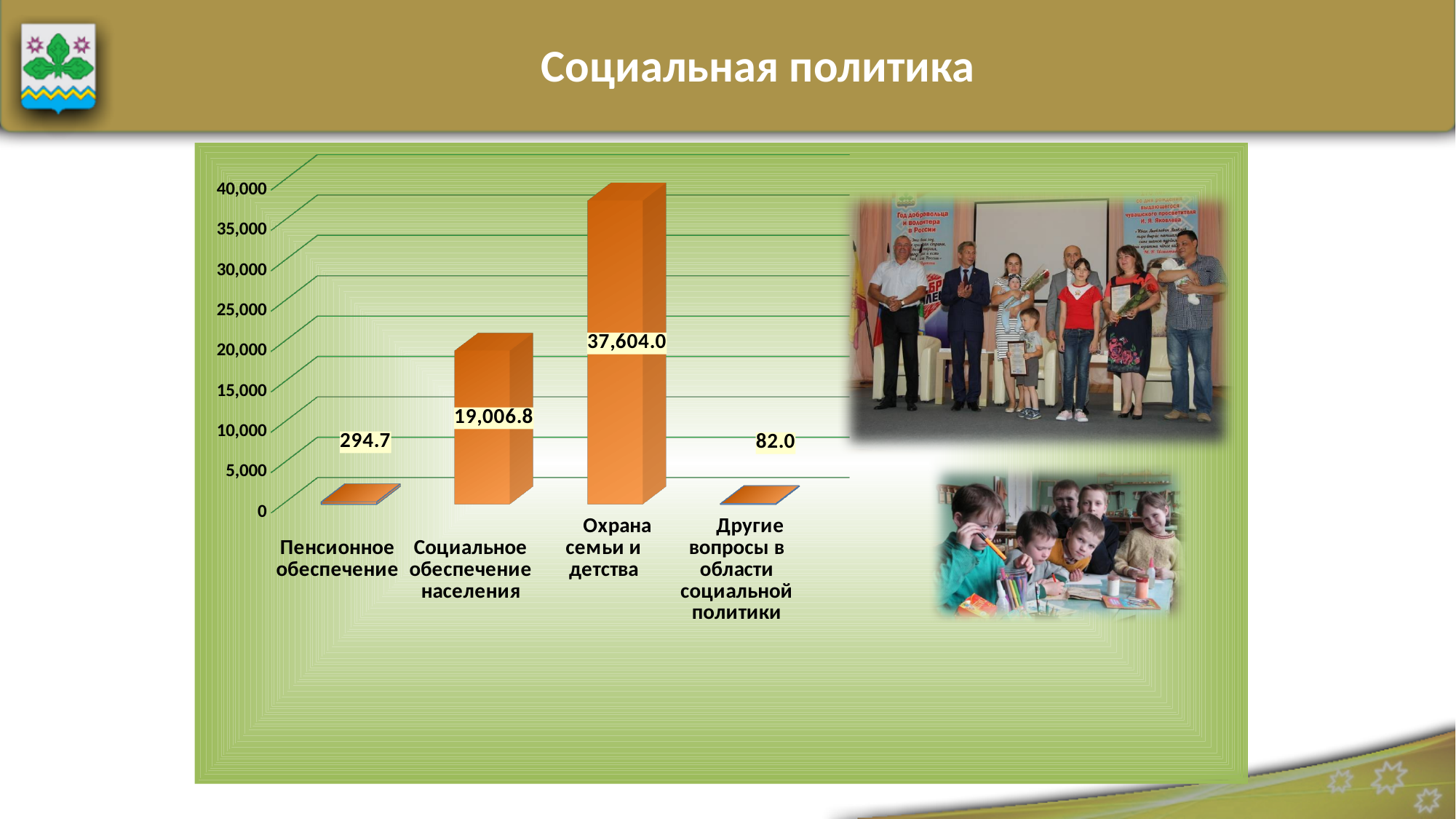
How many categories are shown in the chart? 4 What kind of chart is shown on the slide? bar chart Which category has the lowest value? Другие вопросы в области социальной политики What is the value for Охрана семьи и детства? 37,604.0 What is the difference between the values for Пенсионное обеспечение and Другие вопросы в области социальной политики? 212.7 What is the value for Другие вопросы в области социальной политики? 82.0 What is the difference between the values for Охрана семьи и детства and Социальное обеспечение населения? 18,597.2 What is the value for Пенсионное обеспечение? 294.7 Is the value for Охрана семьи и детства greater or less than 35,000? greater What is the value for Социальное обеспечение населения? 19,006.8 Which category has the highest value? Охрана семьи и детства Which is larger: the value for Социальное обеспечение населения or the value for Пенсионное обеспечение? Социальное обеспечение населения